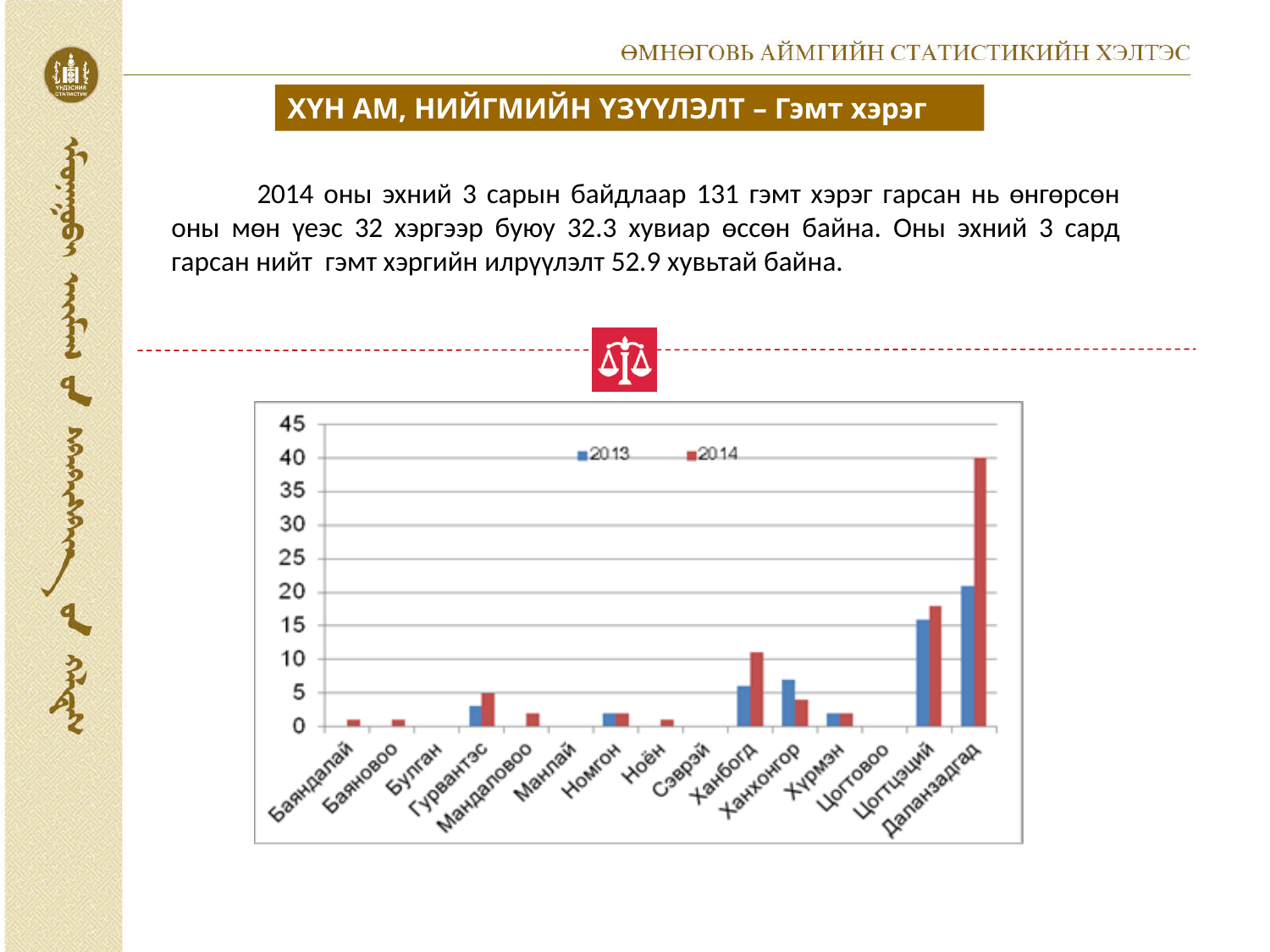
What kind of chart is shown on the slide? bar chart Which colour represents the 2014 series in the chart? red For Ханхонгор, which year has the larger value, 2013 or 2014? 2013 How many series does the chart legend list? 2 Which category has the highest value for 2013? Даланзадгад Which is larger: the 2014 value for Даланзадгад or the 2014 value for Ханбогд? Даланзадгад Is the 2013 value for Цогтцэций greater or less than 10? greater Is the 2014 value for Даланзадгад greater or less than 35? greater How many categories (soums) are shown along the x axis of the chart? 15 Which category has the highest value for 2014? Даланзадгад Which years are shown in the chart legend? 2013 and 2014 Is the 2014 value for Ханбогд greater or less than 5? greater